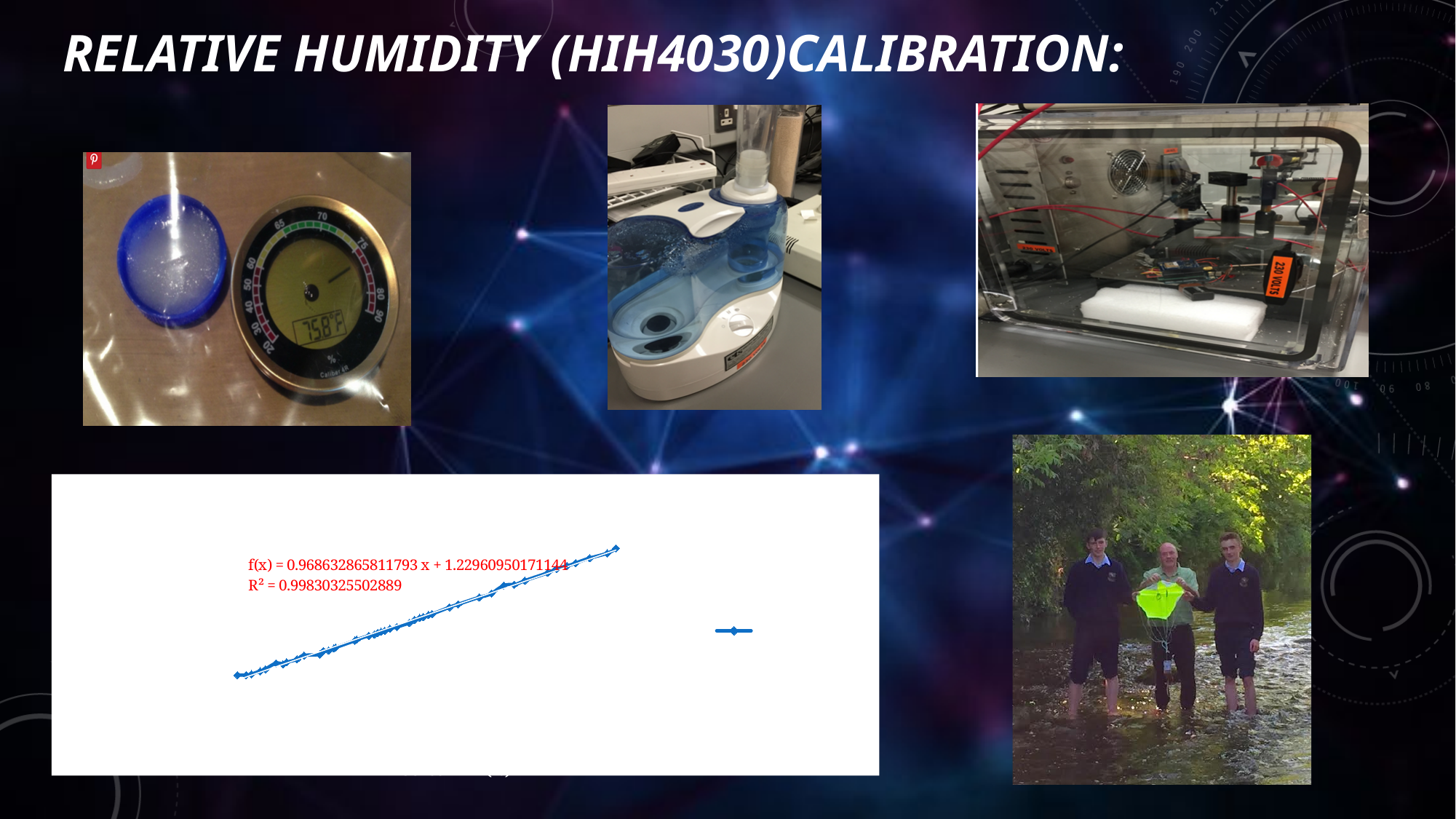
How many series does the chart's legend list? 1 What trendline equation is printed on the chart? f(x) = 0.968632865811793 x + 1.22960950171144 What R² value is printed on the chart? 0.99830325502889 What kind of chart is shown on the slide? scatter chart Do the plotted values rise or fall along the x axis? rise